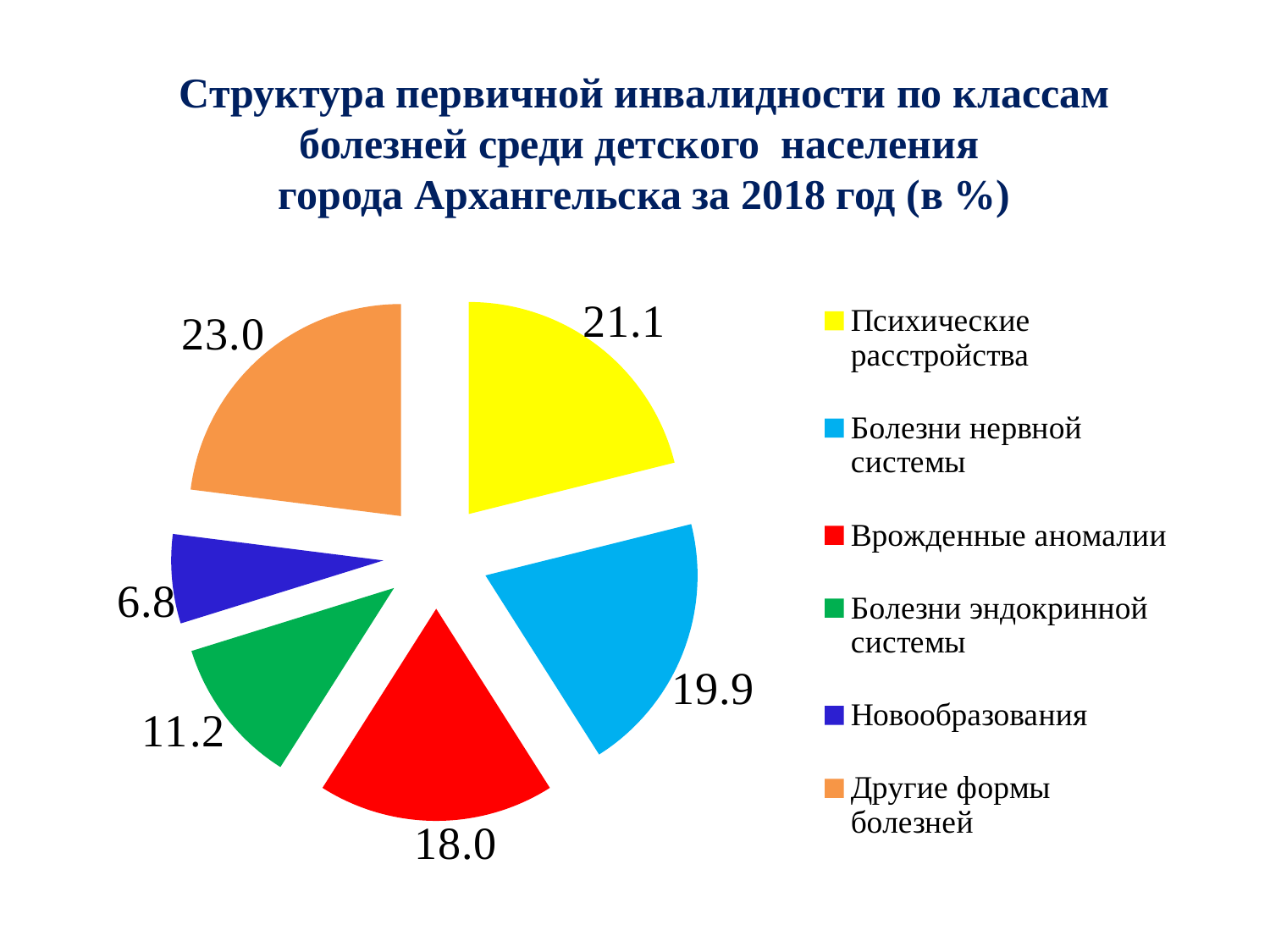
Which category has the smallest share of the pie? Новообразования What is the value for Врожденные аномалии? 18.0 Which is larger, the value for Психические расстройства or the value for Врожденные аномалии? Психические расстройства What is the value for Болезни нервной системы? 19.9 What is the difference between the values for Другие формы болезней and Болезни эндокринной системы? 11.8 What is the value for Новообразования? 6.8 Which category has the largest share of the pie? Другие формы болезней How many categories does the pie chart have? 6 What colour is the slice for Болезни эндокринной системы? green Which year does the chart title refer to? 2018 What is the value for Психические расстройства? 21.1 What kind of chart is shown on the slide? pie chart